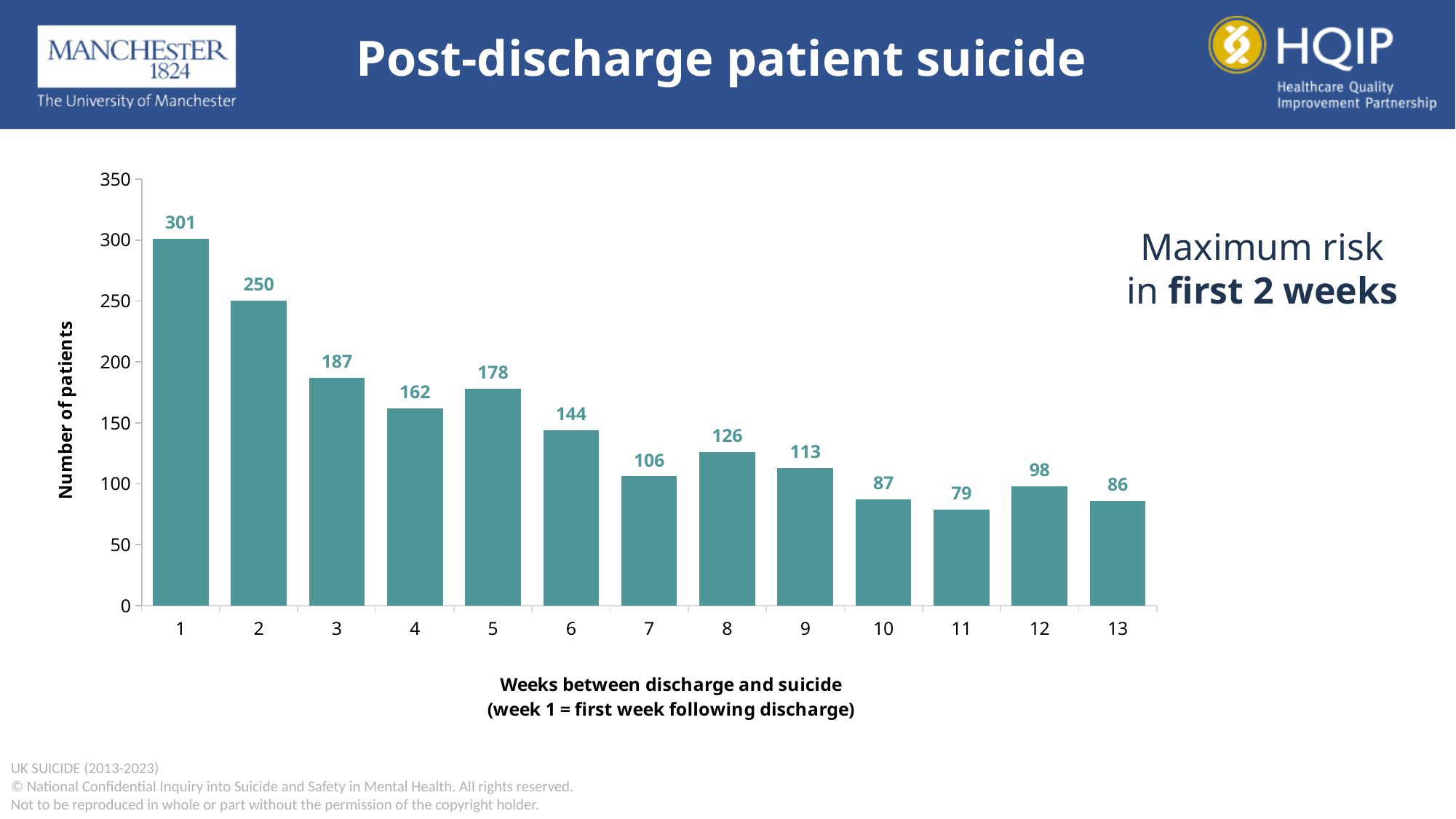
What is the difference in number of patients between week 1 and week 2? 51 What kind of chart is shown on the slide? Bar chart Which has more patients, week 8 or week 9? Week 8 What is the number of patients for week 5? 178 How many weeks are shown on the x axis? 13 How many patients died by suicide in week 1 after discharge? 301 What is the difference in number of patients between week 3 and week 4? 25 Which week has the highest number of patients? Week 1 What is the label of the y axis? Number of patients Which week has the lowest number of patients? Week 11 Is the value for week 6 greater or less than 150? less What is the number of patients for week 11? 79